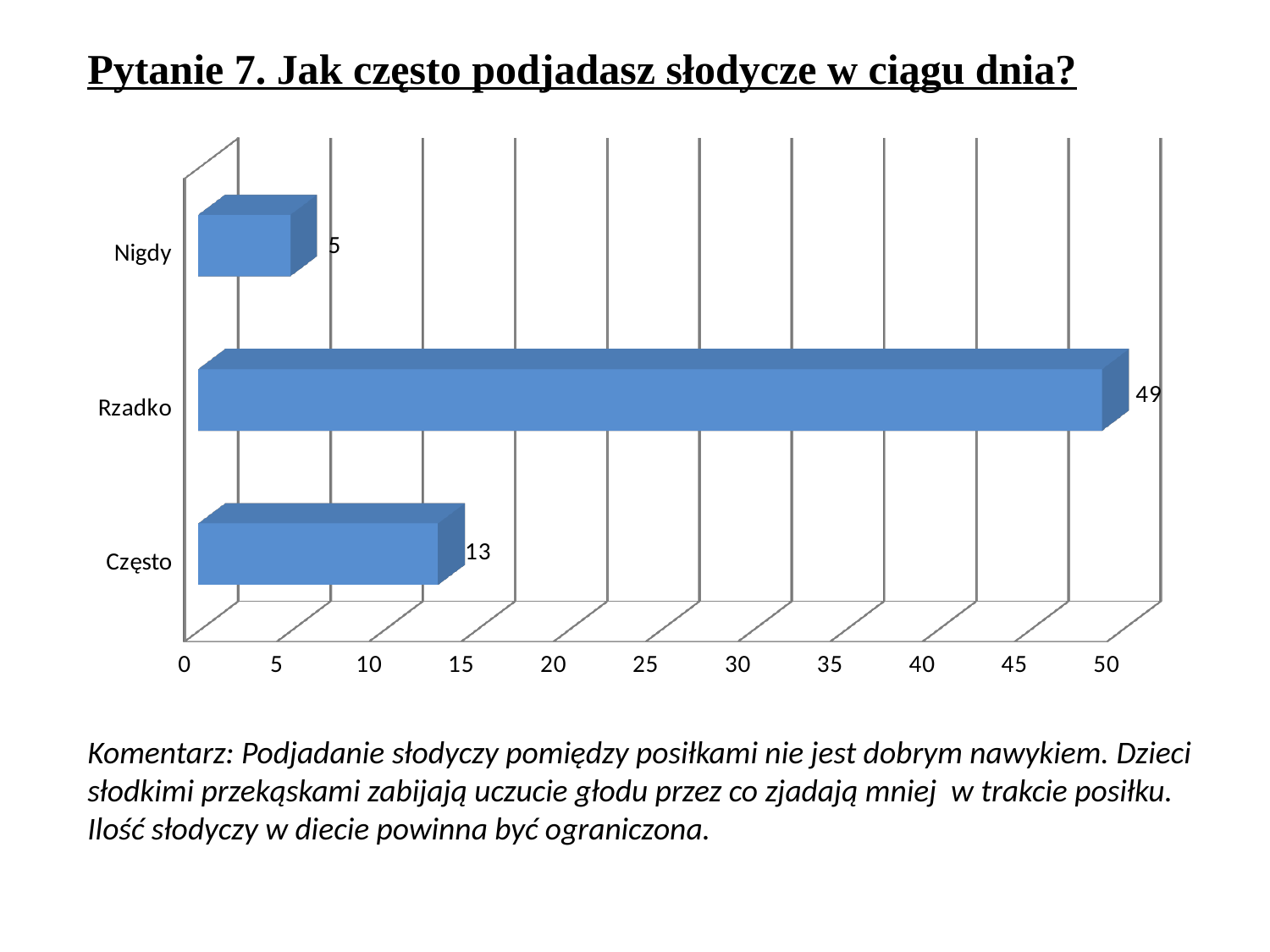
Which category has the lowest value? Nigdy What is the value for Często? 13 Is the value for Rzadko greater or less than 45? greater What is the difference between the values for Często and Nigdy? 8 Which is larger, the value for Często or the value for Nigdy? Często What kind of chart is shown on the slide? bar chart What is the value for Rzadko? 49 What is the value for Nigdy? 5 What is the title of the slide above the chart? Pytanie 7. Jak często podjadasz słodycze w ciągu dnia? What is the difference between the values for Rzadko and Często? 36 Which category has the highest value? Rzadko How many categories are shown in the chart? 3